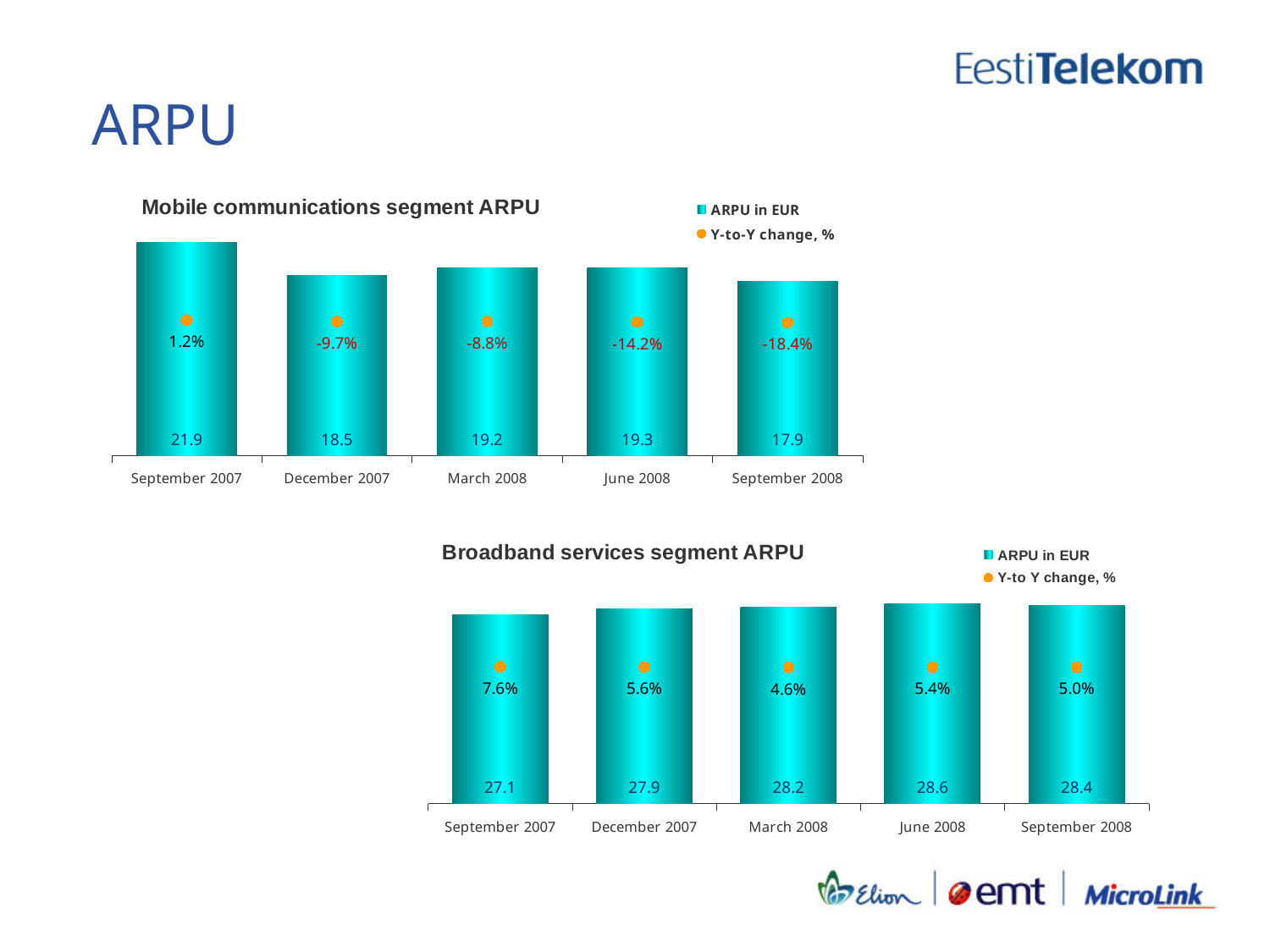
In the Mobile communications segment ARPU chart, what is the difference in ARPU in EUR between September 2007 and September 2008? 4.0 In the Broadband services segment ARPU chart, which period has the highest ARPU in EUR? June 2008 In the Mobile communications segment ARPU chart, what is the Y-to-Y change for June 2008? -14.2% What kind of chart is the Broadband services segment ARPU chart? Bar chart In the Mobile communications segment ARPU chart, how many series does the legend list? 2 In the Mobile communications segment ARPU chart, which period has the lowest ARPU in EUR? September 2008 In the Broadband services segment ARPU chart, what is the difference in ARPU in EUR between June 2008 and September 2007? 1.5 In the Broadband services segment ARPU chart, what is the Y-to-Y change for September 2007? 7.6% In the Broadband services segment ARPU chart, is the ARPU in EUR larger for December 2007 or September 2008? September 2008 In the Broadband services segment ARPU chart, what is the ARPU in EUR for March 2008? 28.2 In the Mobile communications segment ARPU chart, what is the ARPU in EUR for September 2007? 21.9 In the Mobile communications segment ARPU chart, how many periods are shown on the x axis? 5